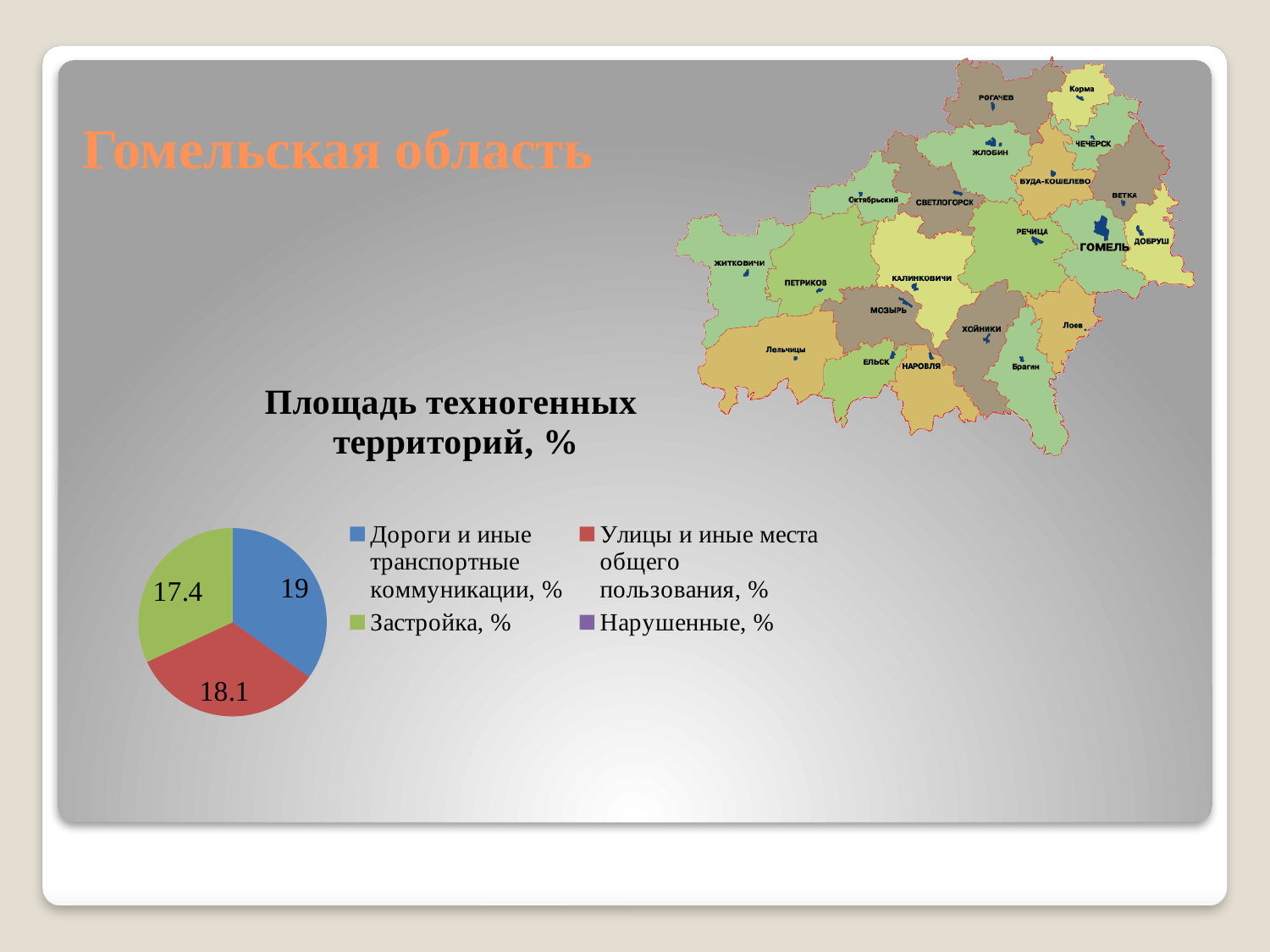
What is the difference between the values for 'Улицы и иные места общего пользования, %' and 'Застройка, %'? 0.7 What value is shown for the slice 'Дороги и иные транспортные коммуникации, %' in the pie chart? 19 Which is larger: the value for 'Дороги и иные транспортные коммуникации, %' or for 'Улицы и иные места общего пользования, %'? Дороги и иные транспортные коммуникации, % Which category has the largest slice in the pie chart? Дороги и иные транспортные коммуникации, % How many slices with data labels are shown in the pie chart? 3 What is the title of the chart on the slide? Площадь техногенных территорий, % What is the difference between the values for 'Дороги и иные транспортные коммуникации, %' and 'Застройка, %'? 1.6 What type of chart is shown on the slide? Pie chart Which labelled slice in the pie chart has the smallest value? Застройка, % What value is shown for the slice 'Улицы и иные места общего пользования, %' in the pie chart? 18.1 How many entries does the legend of the pie chart list? 4 What value is shown for the slice 'Застройка, %' in the pie chart? 17.4